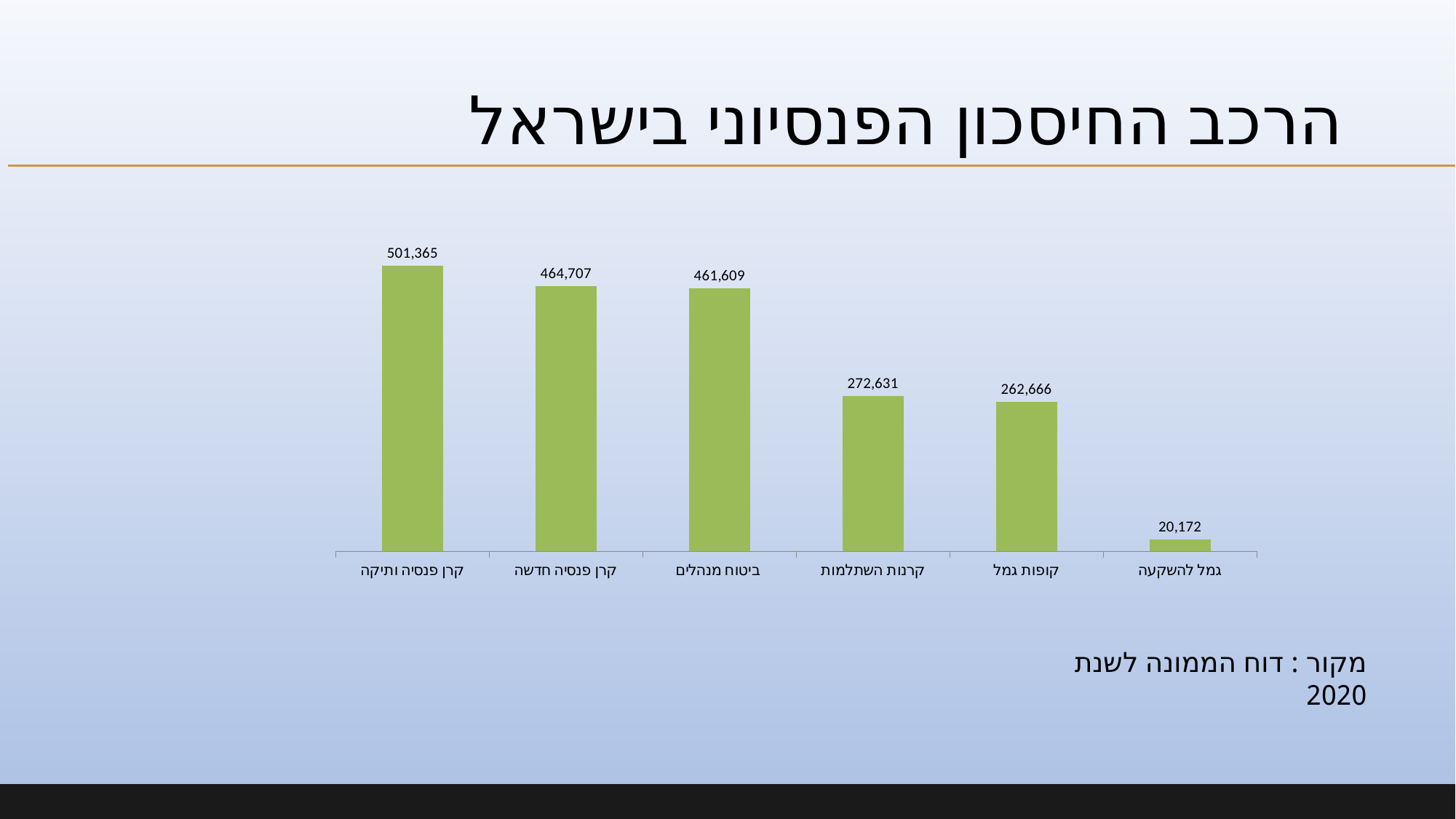
What kind of chart is shown on the slide? Bar chart Which category has the lowest value? גמל להשקעה Which category has the highest value? קרן פנסיה ותיקה What is the value for קרן פנסיה ותיקה? 501,365 What is the title of the slide? הרכב החיסכון הפנסיוני בישראל Which is larger, the value for קרן פנסיה ותיקה or the value for קרנות השתלמות? קרן פנסיה ותיקה How many categories are shown in the chart? 6 What is the value for ביטוח מנהלים? 461,609 What is the difference between the values for קרן פנסיה חדשה and ביטוח מנהלים? 3,098 What is the value for קופות גמל? 262,666 What is the value for גמל להשקעה? 20,172 What is the difference between the values for קרנות השתלמות and קופות גמל? 9,965